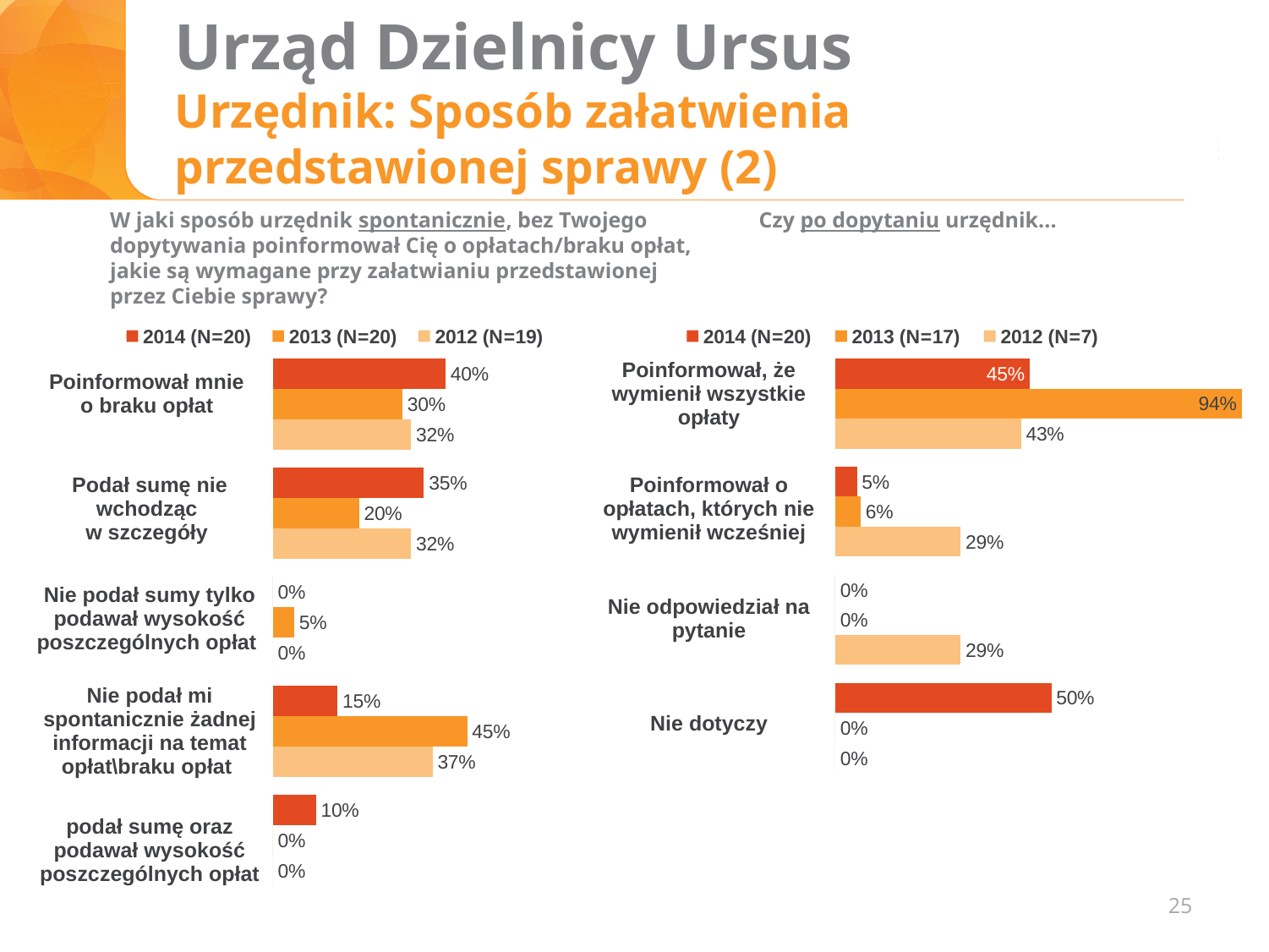
In the right chart, what is the 2013 (N=17) value for "Poinformował, że wymienił wszystkie opłaty"? 94% In the right chart, which category has the highest 2014 (N=20) value? Nie dotyczy In the left chart, what is the 2014 (N=20) value for "Poinformował mnie o braku opłat"? 40% In the right chart, which is larger for "Poinformował o opłatach, których nie wymienił wcześniej": the 2012 (N=7) value or the 2014 (N=20) value? 2012 (N=7) In the left chart, which category has the lowest 2014 (N=20) value? Nie podał sumy tylko podawał wysokość poszczególnych opłat In the right chart, what is the 2012 (N=7) value for "Nie odpowiedział na pytanie"? 29% How many series does the legend of the right chart list? 3 In the left chart, what is the 2013 (N=20) value for "Nie podał mi spontanicznie żadnej informacji na temat opłat\braku opłat"? 45% In the left chart, what is the 2014 (N=20) value for "podał sumę oraz podawał wysokość poszczególnych opłat"? 10% What type of chart is the right chart? Bar chart How many categories does the left chart show? 5 In the left chart, what is the difference between the 2014 (N=20) and 2013 (N=20) values for "Podał sumę nie wchodząc w szczegóły"? 15 percentage points